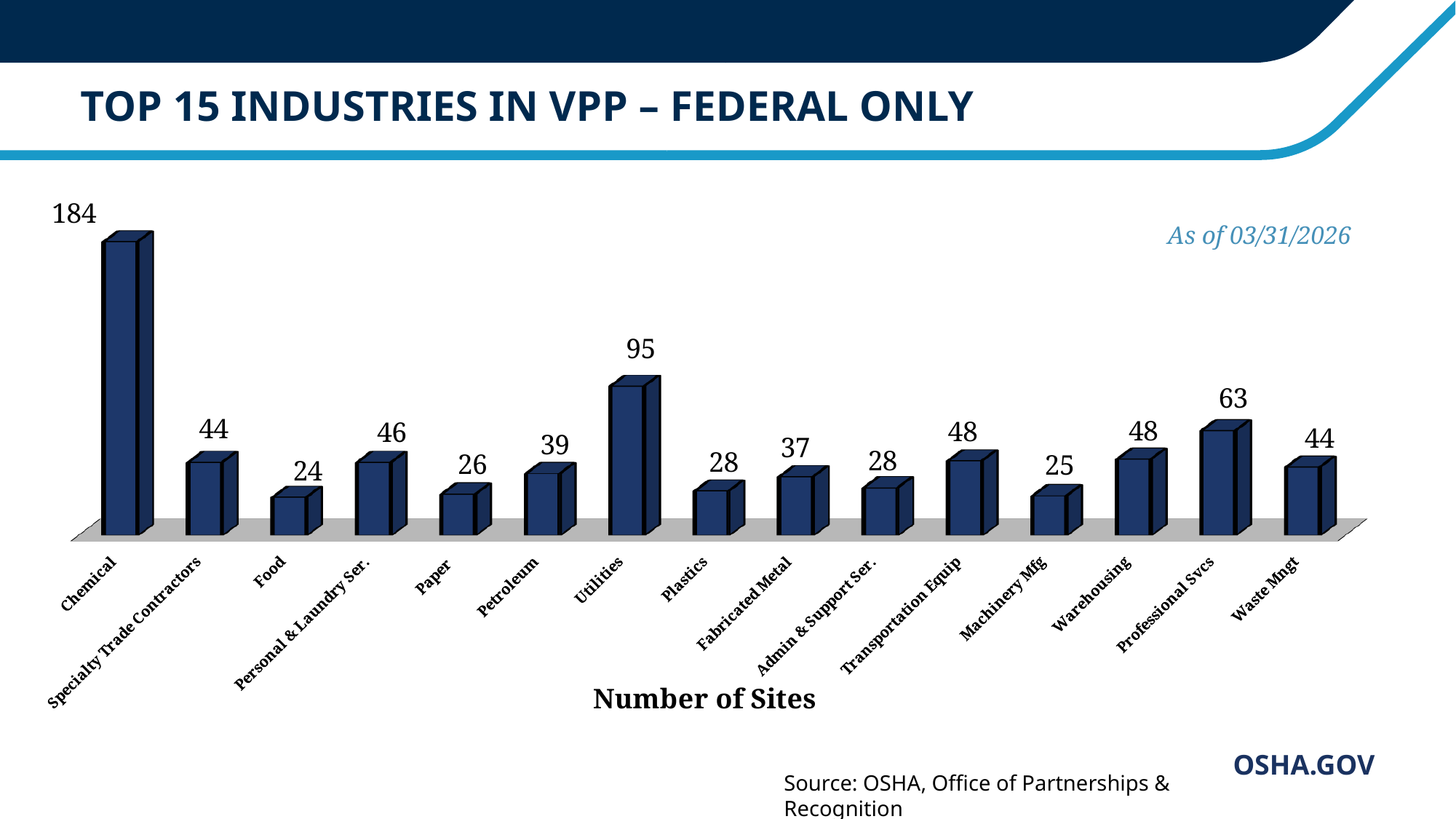
What type of chart is shown on the slide? Bar chart Which industry has the highest number of sites? Chemical What is the title of the chart on the slide? Top 15 Industries in VPP – Federal Only Which has more sites, Personal & Laundry Ser. or Specialty Trade Contractors? Personal & Laundry Ser. Which industry has the lowest number of sites? Food What is the difference in number of sites between Chemical and Utilities? 89 What is the difference in number of sites between Professional Svcs and Petroleum? 24 Which has more sites, Fabricated Metal or Plastics? Fabricated Metal What is the number of sites for Professional Svcs? 63 How many industries are shown in the chart? 15 How many sites does the Chemical industry have? 184 What is the number of sites for Utilities? 95